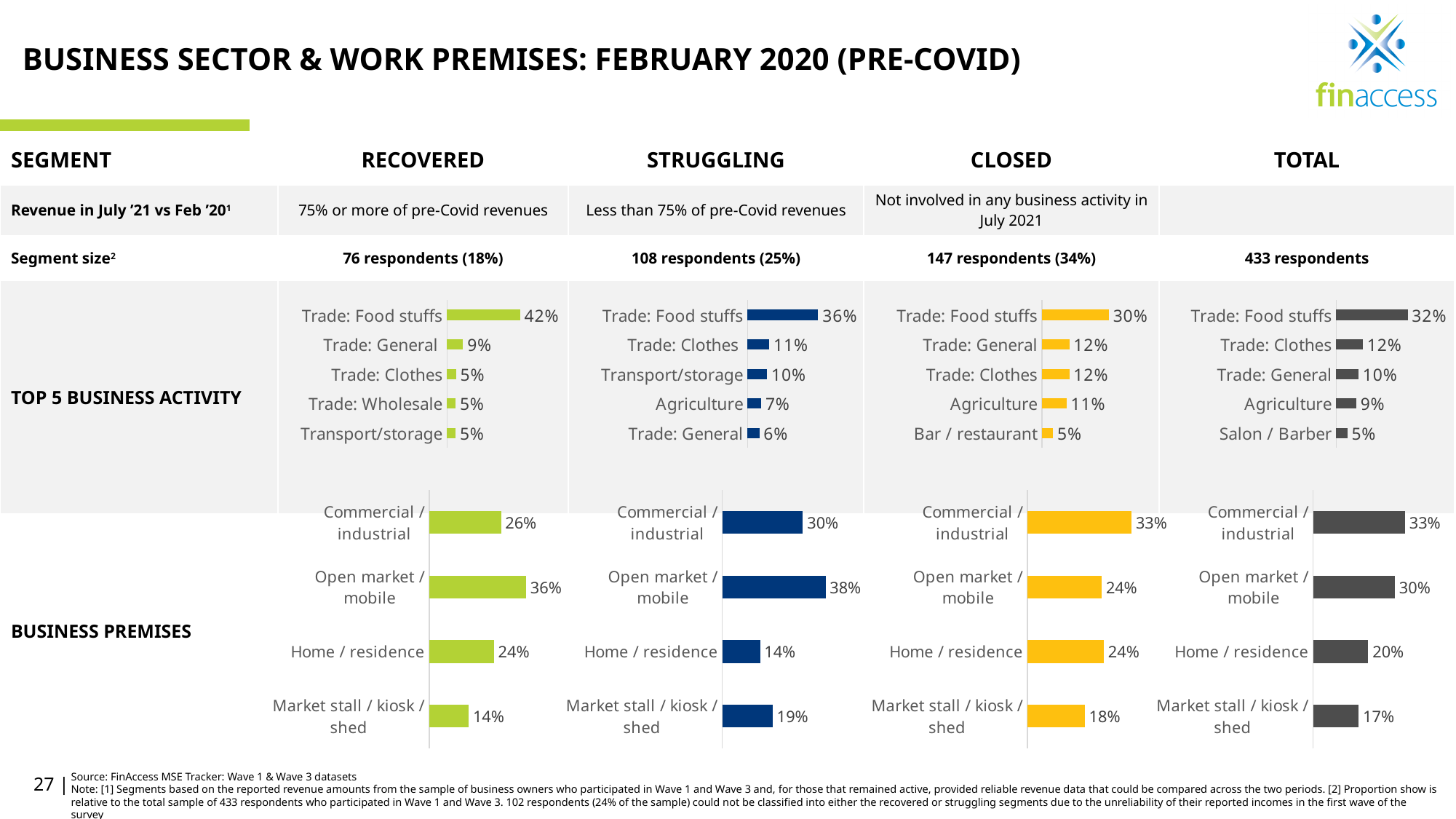
How many categories are shown in the Business Premises chart for the Recovered segment? 4 In the Business Premises chart for the Closed segment, what is the difference between Commercial / industrial and Market stall / kiosk / shed? 15% In the Business Premises chart for the Recovered segment, what is the value for Open market / mobile? 36% In the Top 5 Business Activity chart for the Recovered segment, what is the value for Trade: Food stuffs? 42% What colour are the bars in the Closed segment charts? Yellow What kind of chart is used for the Top 5 Business Activity in the Struggling segment? Bar chart In the Business Premises chart for the Struggling segment, which category has the highest value? Open market / mobile In the Top 5 Business Activity chart for the Closed segment, which category has the highest value? Trade: Food stuffs In the Top 5 Business Activity chart for the Closed segment, what is the difference between Trade: Food stuffs and Bar / restaurant? 25% In the Top 5 Business Activity chart for the Total column, which category has the lowest value? Salon / Barber In the Business Premises chart for the Total column, which is larger: Home / residence or Market stall / kiosk / shed? Home / residence In the Top 5 Business Activity chart for the Struggling segment, what is the value for Transport/storage? 10%